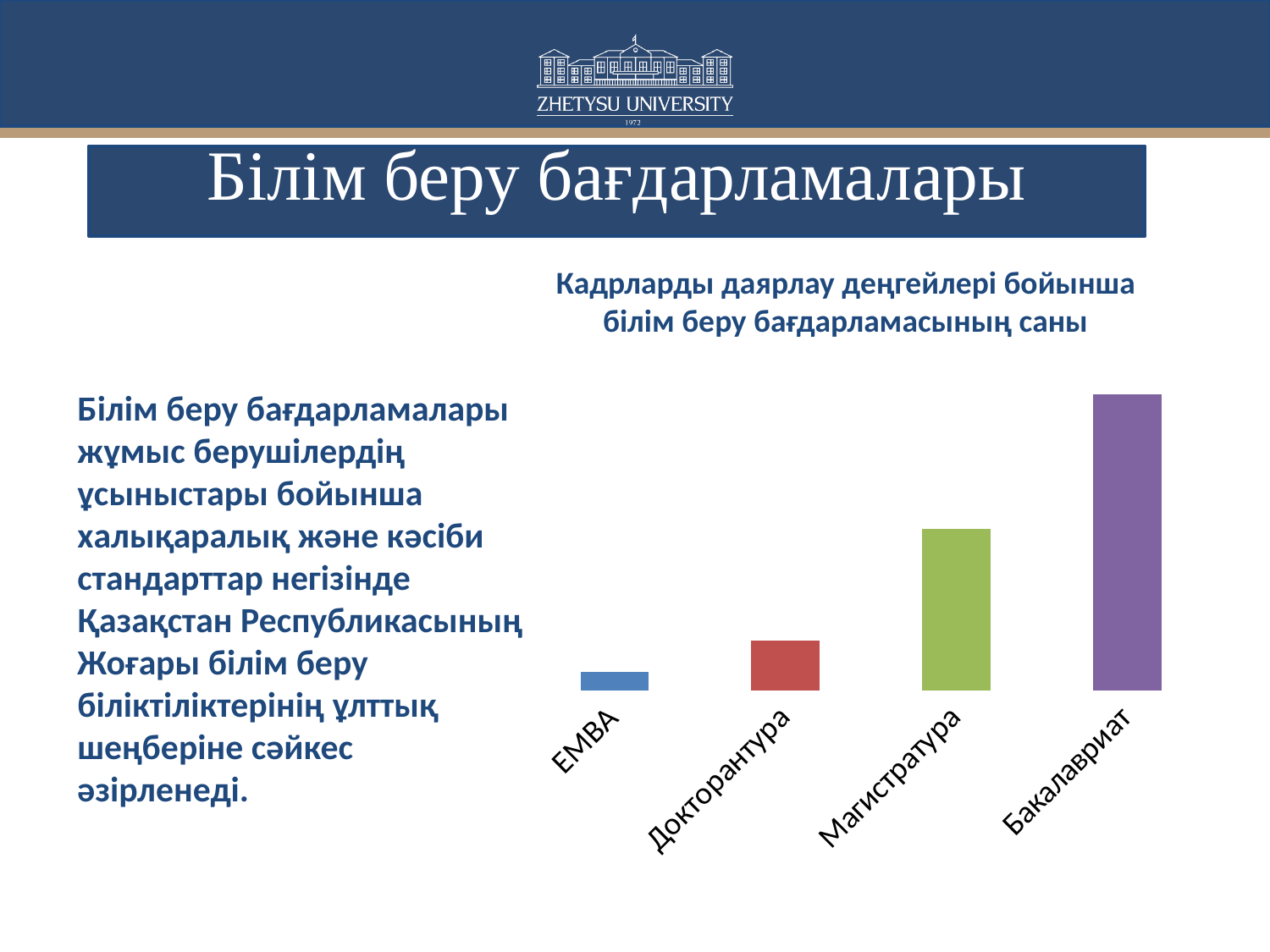
Which category has the shortest bar in the chart? EMBA Which has the larger value, Магистратура or Бакалавриат? Бакалавриат Which category has the tallest bar in the chart? Бакалавриат Which has the larger value, Докторантура or Магистратура? Магистратура Which category is the second from the left on the x axis? Докторантура What is the title of the chart? Кадрларды даярлау деңгейлері бойынша білім беру бағдарламасының саны Which has the larger value, EMBA or Докторантура? Докторантура How many categories does the chart show? 4 Do the bar values rise or fall from left to right along the x axis? rise What colour is the bar for Бакалавриат? purple What kind of chart is shown on the slide? bar chart